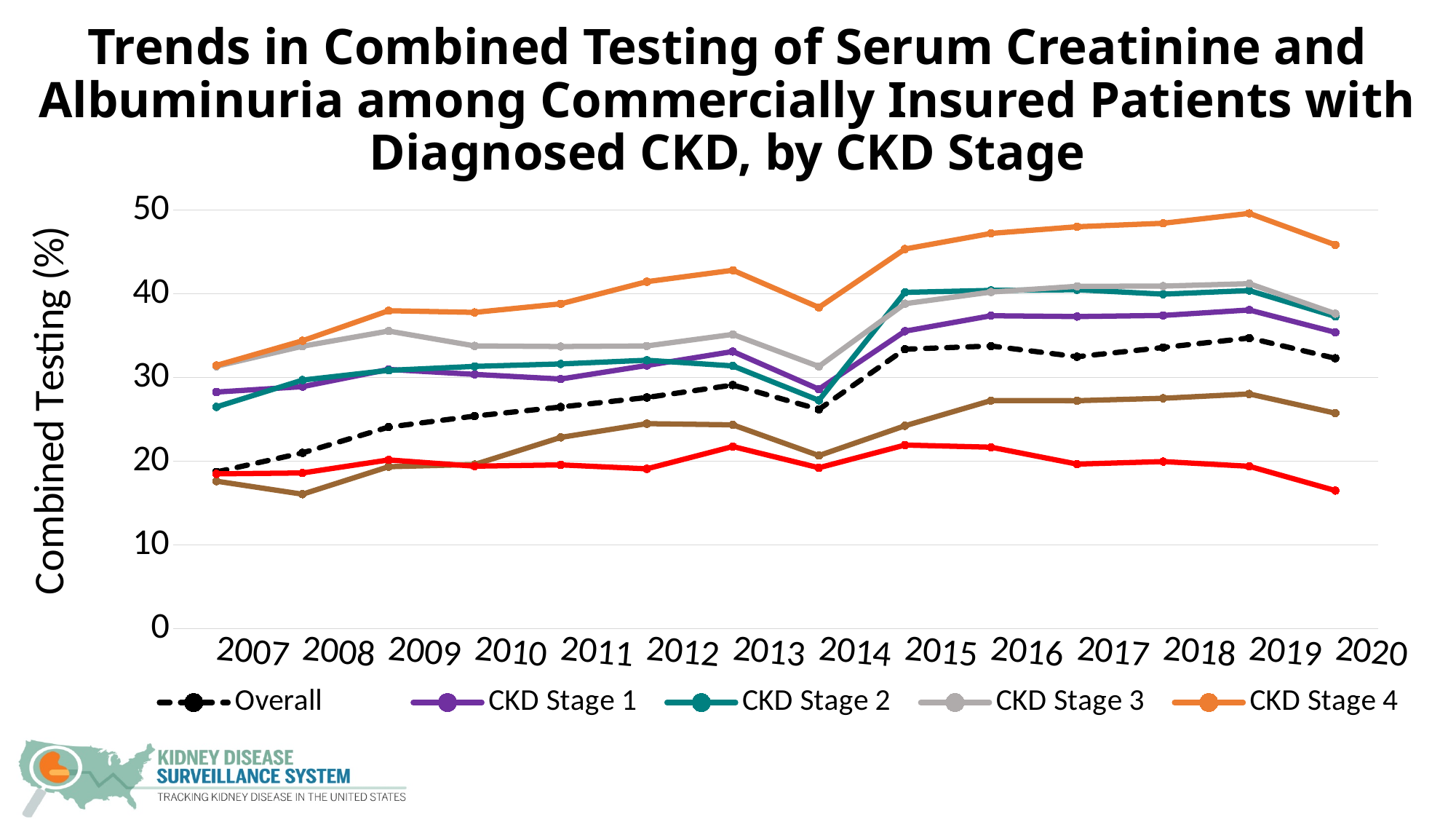
Is the value for CKD Stage 4 in 2019 greater or less than 40? greater How many years are shown on the x axis? 14 In 2015, which is higher: CKD Stage 2 or Overall? CKD Stage 2 Does the CKD Stage 4 series rise or fall from 2019 to 2020? fall What is the label of the y axis? Combined Testing (%) Is the value for Overall in 2007 greater or less than 20? less Which series has the highest value in 2020? CKD Stage 4 In which year does CKD Stage 4 reach its highest value? 2019 What kind of chart is shown on the slide? line chart Does the Overall series rise or fall from 2007 to 2013? rise How many series does the legend list? 5 Is the value for CKD Stage 1 in 2014 greater or less than 30? less